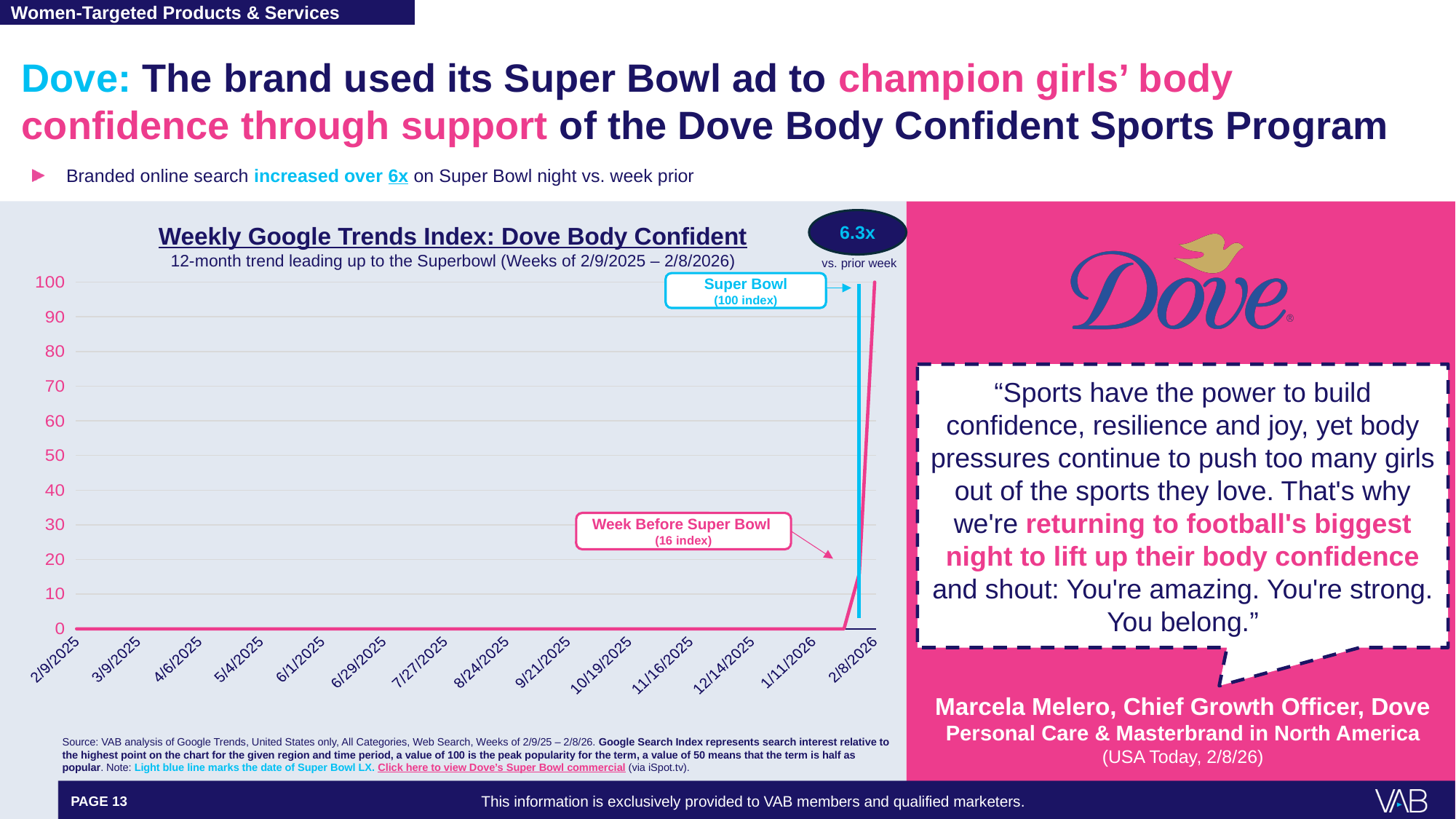
What multiplier versus the prior week is shown in the callout above the chart? 6.3x What is the Google Trends index value for the week before the Super Bowl? 16 What is the highest value shown on the y-axis of the chart? 100 What type of chart is shown on the slide? line chart What is the Google Trends index value for the Super Bowl week? 100 What is the difference between the Super Bowl week index and the week-before index? 84 What is the first date label on the x-axis of the chart? 2/9/2025 Which week has the highest index value on the chart? Super Bowl week (2/8/2026) Which is larger, the index for the Super Bowl week or the index for the week before the Super Bowl? Super Bowl week Does the index value rise or fall between the week before the Super Bowl and the Super Bowl week? rise Is the index value for the week before the Super Bowl greater or less than 20? less What is the title of the chart on the slide? Weekly Google Trends Index: Dove Body Confident